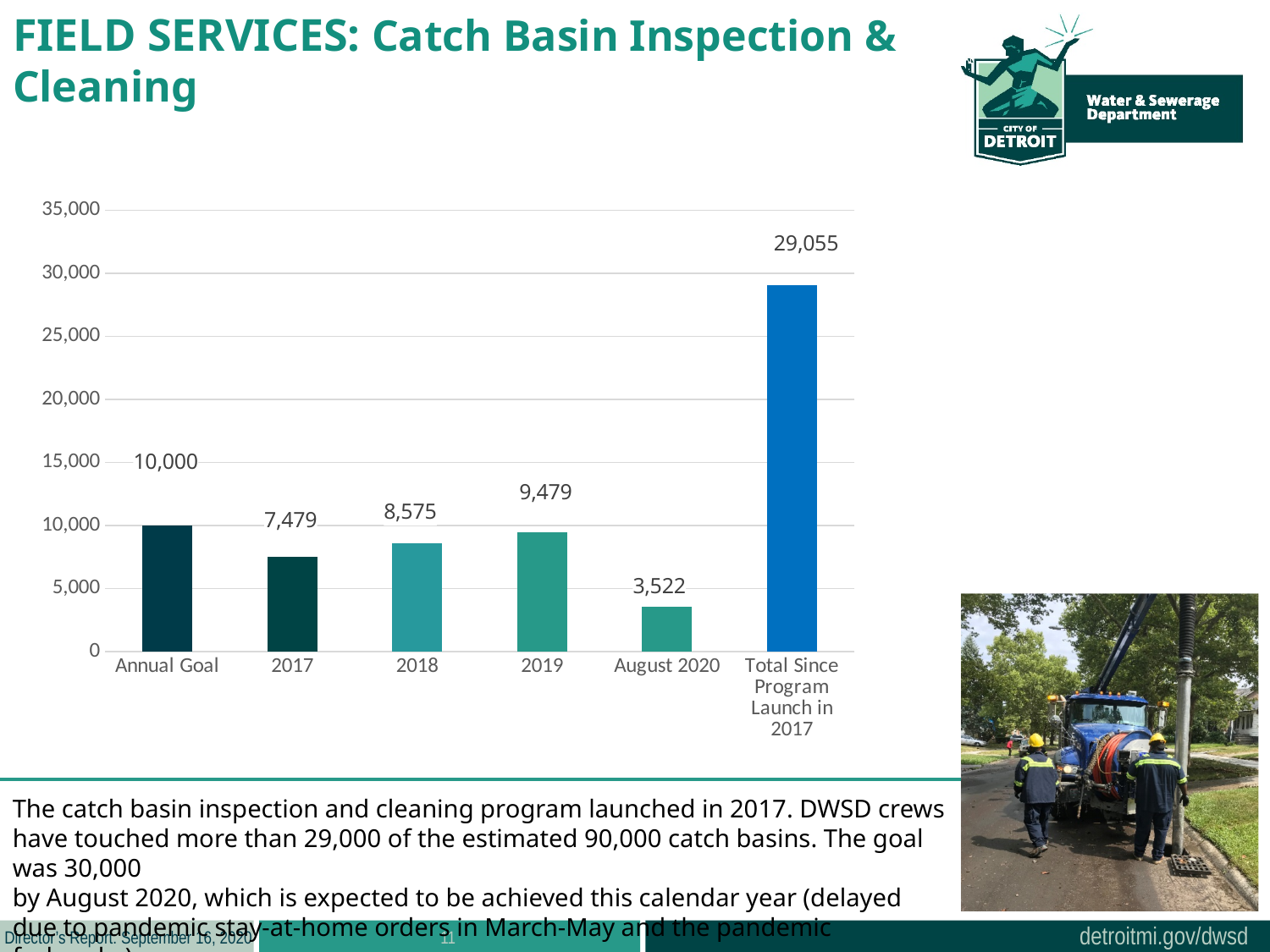
Which category has the highest value? Total Since Program Launch in 2017 What kind of chart is shown on the slide? bar chart Do the values rise or fall from 2017 to 2019? rise How many categories are shown on the x axis? 6 What is the value for 2019? 9,479 Which is larger, the value for 2018 or the value for 2017? 2018 What is the value for August 2020? 3,522 What is the difference between the Annual Goal and the value for 2017? 2,521 Which category has the lowest value? August 2020 What is the value for Annual Goal? 10,000 What is the difference between the values for 2019 and 2018? 904 Is the value for Total Since Program Launch in 2017 greater or less than 25,000? greater